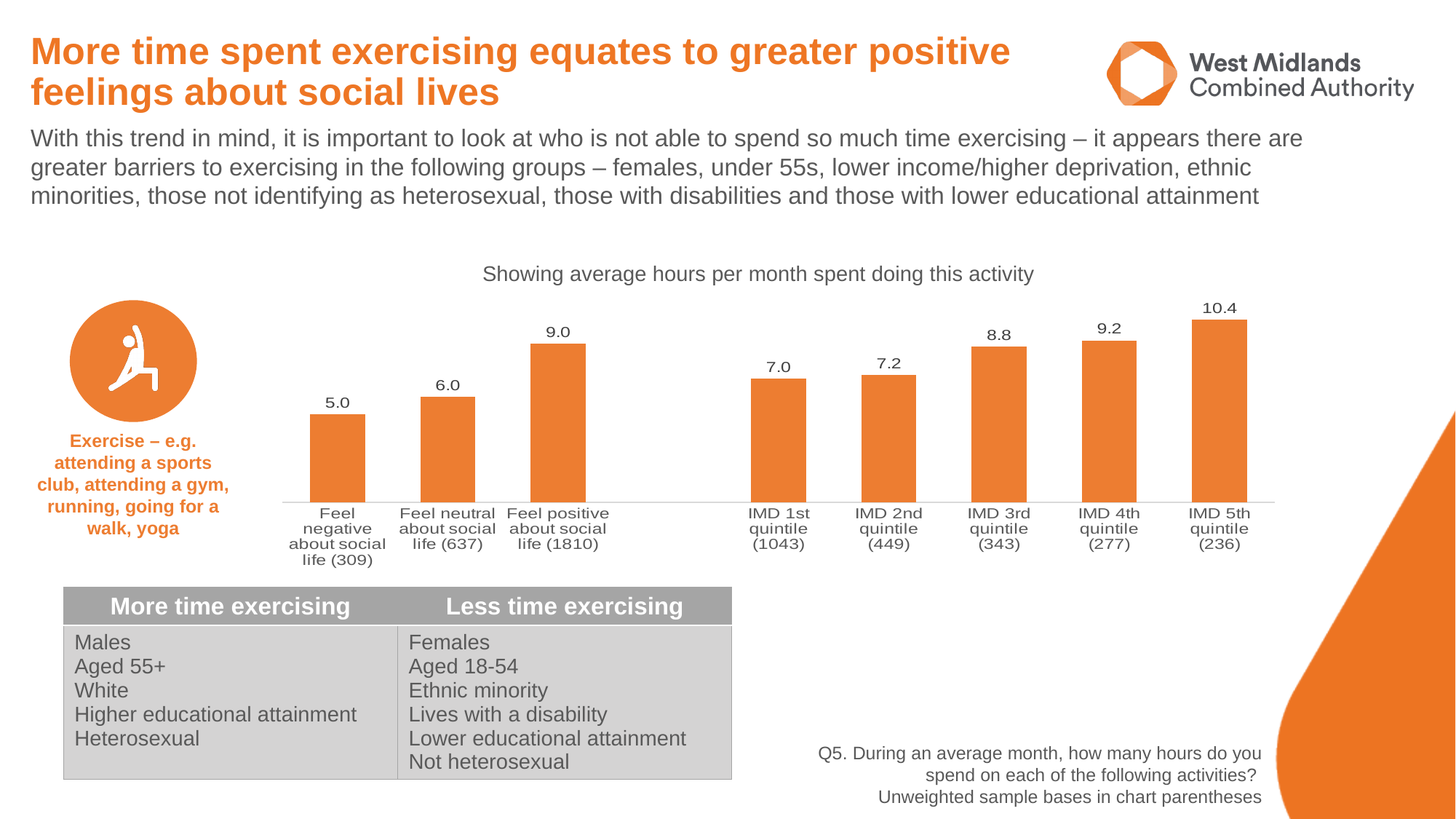
Which category has the highest average hours per month spent exercising? IMD 5th quintile What is the difference in average hours per month between those who feel positive and those who feel negative about social life? 4.0 Do the values rise or fall from IMD 1st quintile to IMD 5th quintile? Rise What is the difference in average hours per month between the IMD 5th quintile and the IMD 1st quintile? 3.4 What is the average hours per month spent exercising for those who feel negative about social life? 5.0 What is the average hours per month spent exercising for those who feel positive about social life? 9.0 What type of chart is shown on the slide? Bar chart What is the unweighted sample base for the IMD 1st quintile? 1043 How many categories are shown in the chart? 8 What is the average hours per month spent exercising for the IMD 5th quintile? 10.4 Which has a higher average hours per month: IMD 3rd quintile or Feel neutral about social life? IMD 3rd quintile Which category has the lowest average hours per month spent exercising? Feel negative about social life